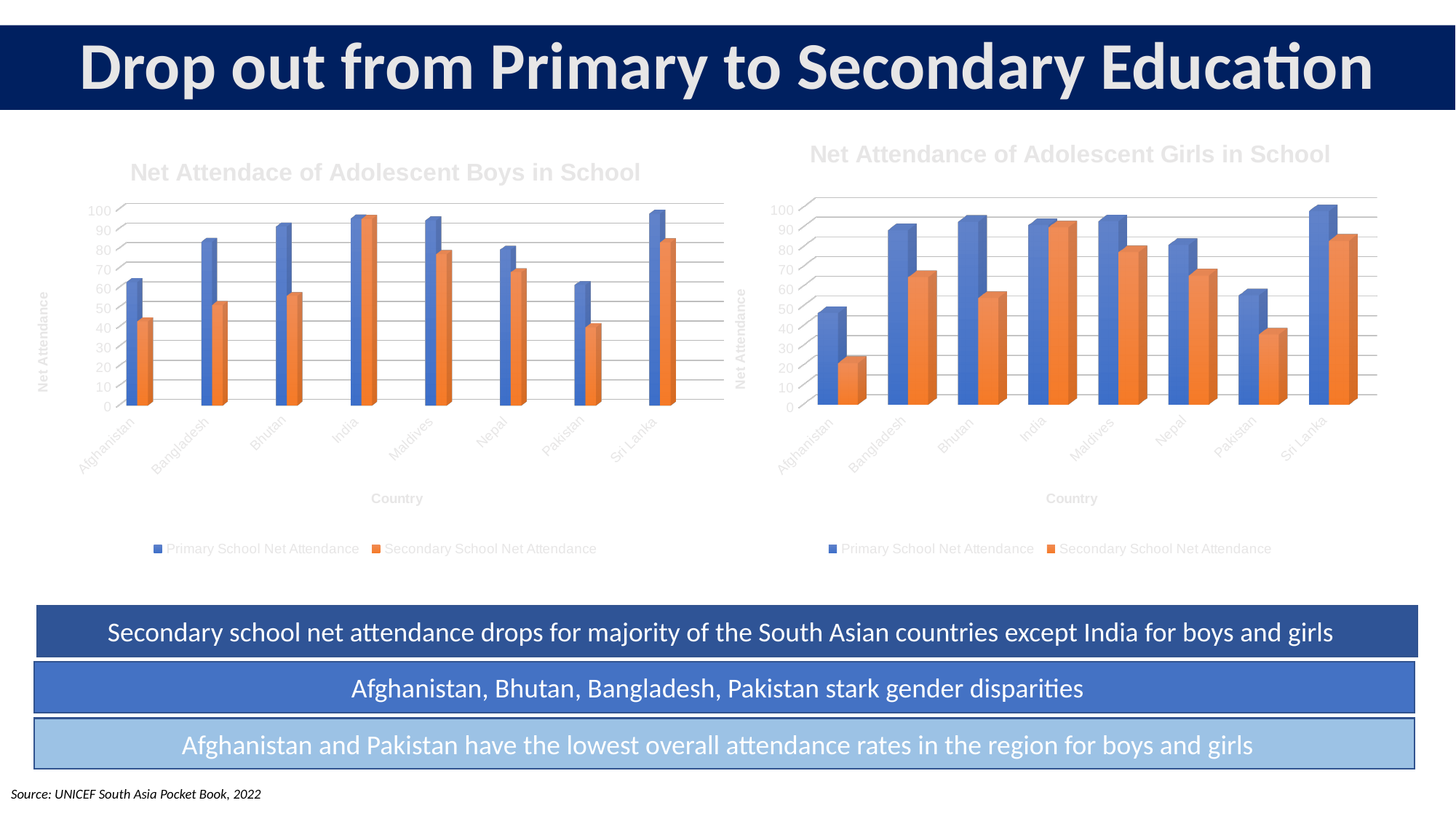
In the 'Net Attendance of Adolescent Girls in School' chart, which is larger for Pakistan: Primary School Net Attendance or Secondary School Net Attendance? Primary School Net Attendance In the 'Net Attendance of Adolescent Girls in School' chart, which country has the lowest Secondary School Net Attendance? Afghanistan In the 'Net Attendance of Adolescent Girls in School' chart, which country has the lowest Primary School Net Attendance? Afghanistan How many countries are shown on the 'Net Attendance of Adolescent Girls in School' chart? 8 In the 'Net Attendance of Adolescent Girls in School' chart, is the Secondary School Net Attendance for Afghanistan greater or less than 30? less How many series does the legend of the 'Net Attendace of Adolescent Boys in School' chart list? 2 What kind of chart is the 'Net Attendace of Adolescent Boys in School' chart? bar chart In the 'Net Attendance of Adolescent Girls in School' chart, which country has the highest Secondary School Net Attendance? India In the 'Net Attendace of Adolescent Boys in School' chart, is the Primary School Net Attendance for Sri Lanka greater or less than 90? greater In the 'Net Attendace of Adolescent Boys in School' chart, which is larger for Bangladesh: Primary School Net Attendance or Secondary School Net Attendance? Primary School Net Attendance In the 'Net Attendace of Adolescent Boys in School' chart, is the Secondary School Net Attendance for Afghanistan greater or less than 50? less What is the title of the vertical axis on the 'Net Attendace of Adolescent Boys in School' chart? Net Attendance